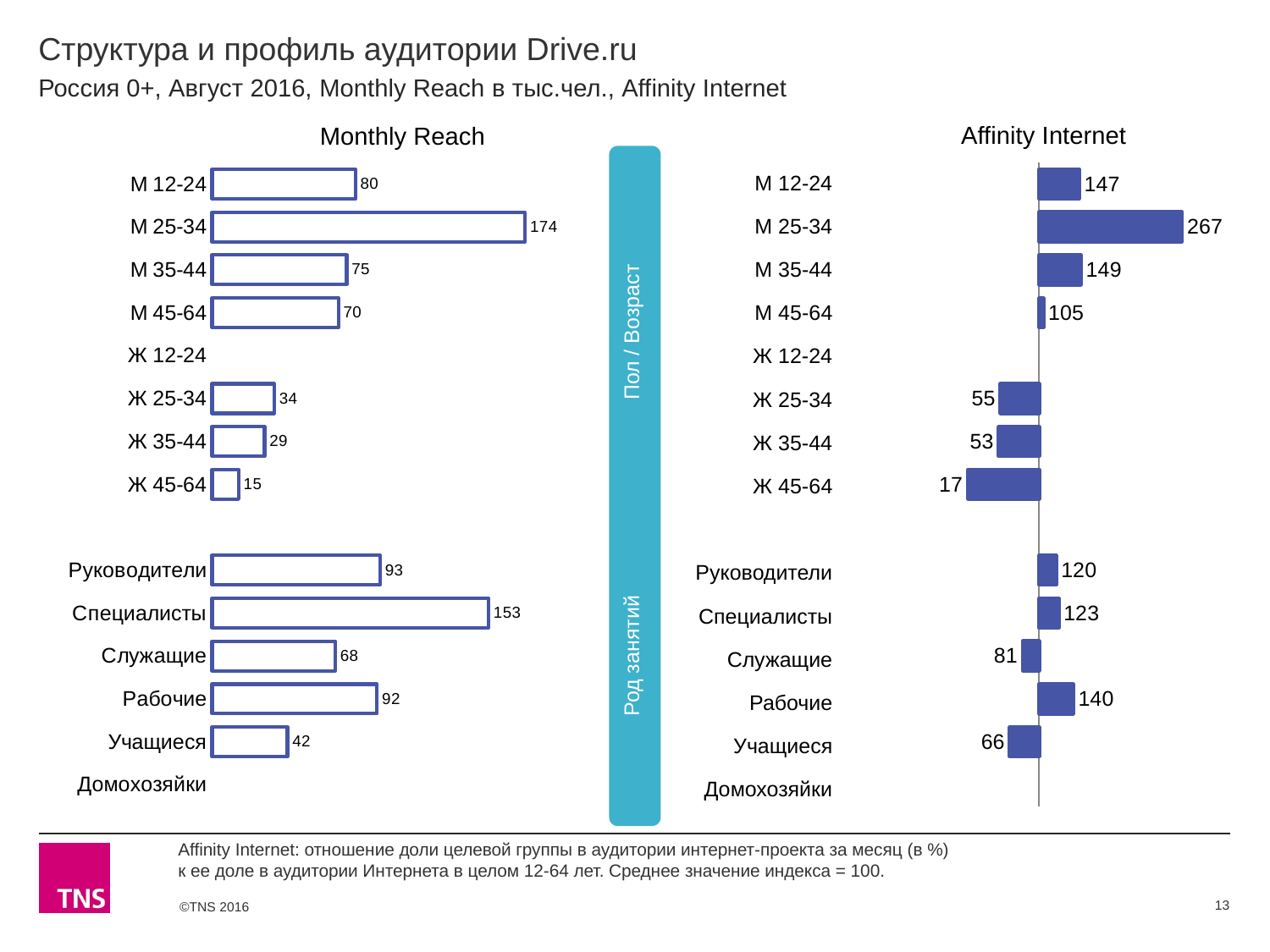
In the Monthly Reach chart, what is the value for М 25-34? 174 In the Monthly Reach chart, which of the labelled categories has the lowest value? Ж 45-64 In the Monthly Reach chart, which is larger: Руководители or Рабочие? Руководители In the Monthly Reach chart, what is the value for Специалисты? 153 In the Affinity Internet chart, what is the value for Рабочие? 140 In the Affinity Internet chart, which category has the highest value? М 25-34 In the Affinity Internet chart, what is the difference between the values for Специалисты and Руководители? 3 What type of chart is the Monthly Reach chart? Bar chart In the Affinity Internet chart, which is larger: Служащие or Учащиеся? Служащие In the Monthly Reach chart, what is the difference between the values for М 25-34 and М 12-24? 94 In the Affinity Internet chart, what is the value for Ж 45-64? 17 In the Monthly Reach chart, do the values for the male age groups rise or fall from М 25-34 to М 45-64? Fall